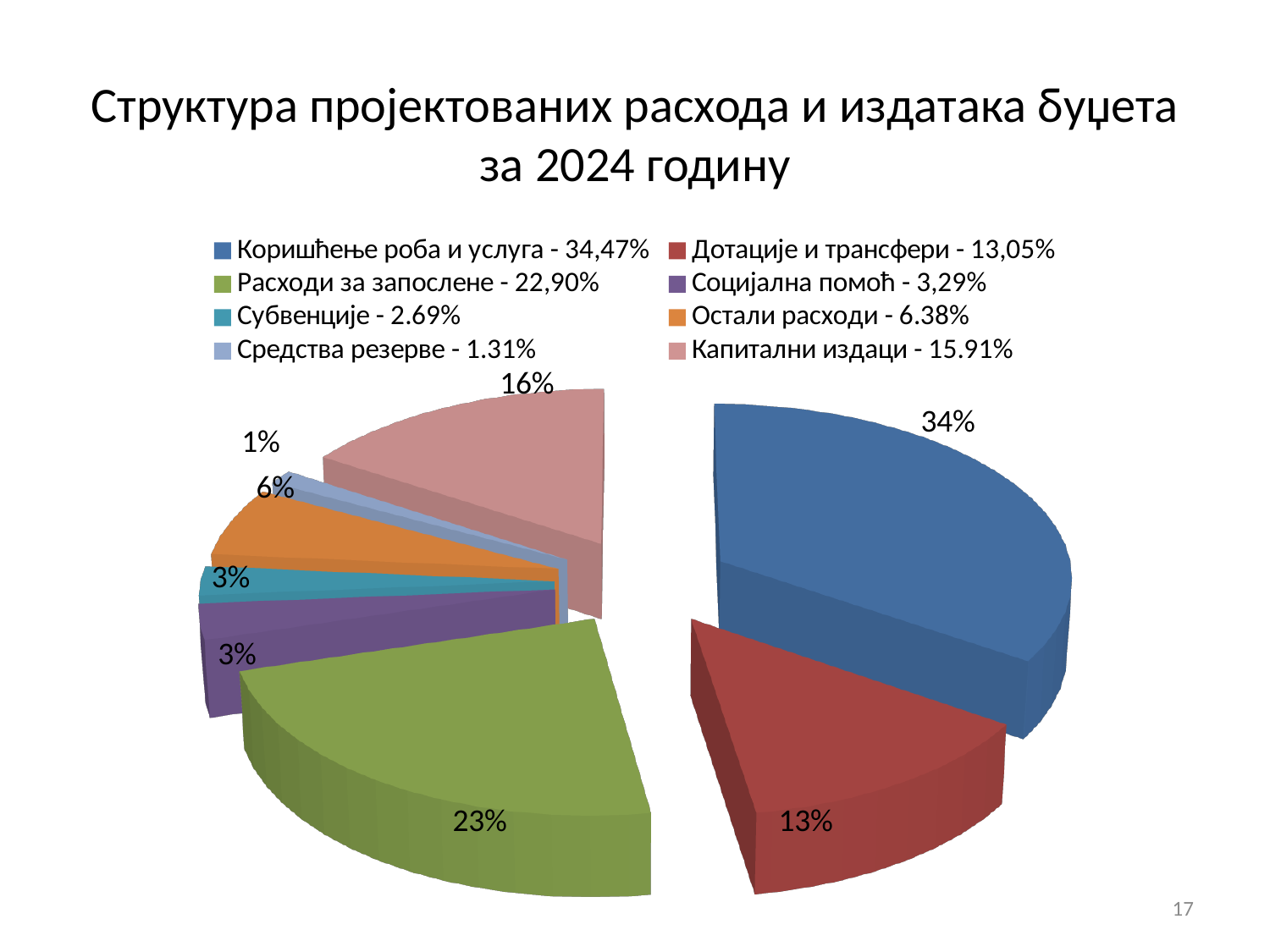
What kind of chart is shown on the slide? pie chart What percentage label is shown on the slice for Дотације и трансфери? 13% How many slices does the pie chart have? 8 What is the difference between the slice labels for Коришћење роба и услуга and Дотације и трансфери? 21% What percentage label is shown on the slice for Коришћење роба и услуга? 34% What is the title of the chart on the slide? Структура пројектованих расхода и издатака буџета за 2024 годину What percentage label is shown on the slice for Расходи за запослене? 23% Which category has the largest slice of the pie? Коришћење роба и услуга What percentage label is shown on the slice for Капитални издаци? 16% According to the legend, what exact share does Социјална помоћ have? 3,29% Which category has the smallest slice of the pie? Средства резерве Which is larger, the slice for Остали расходи or the slice for Субвенције? Остали расходи